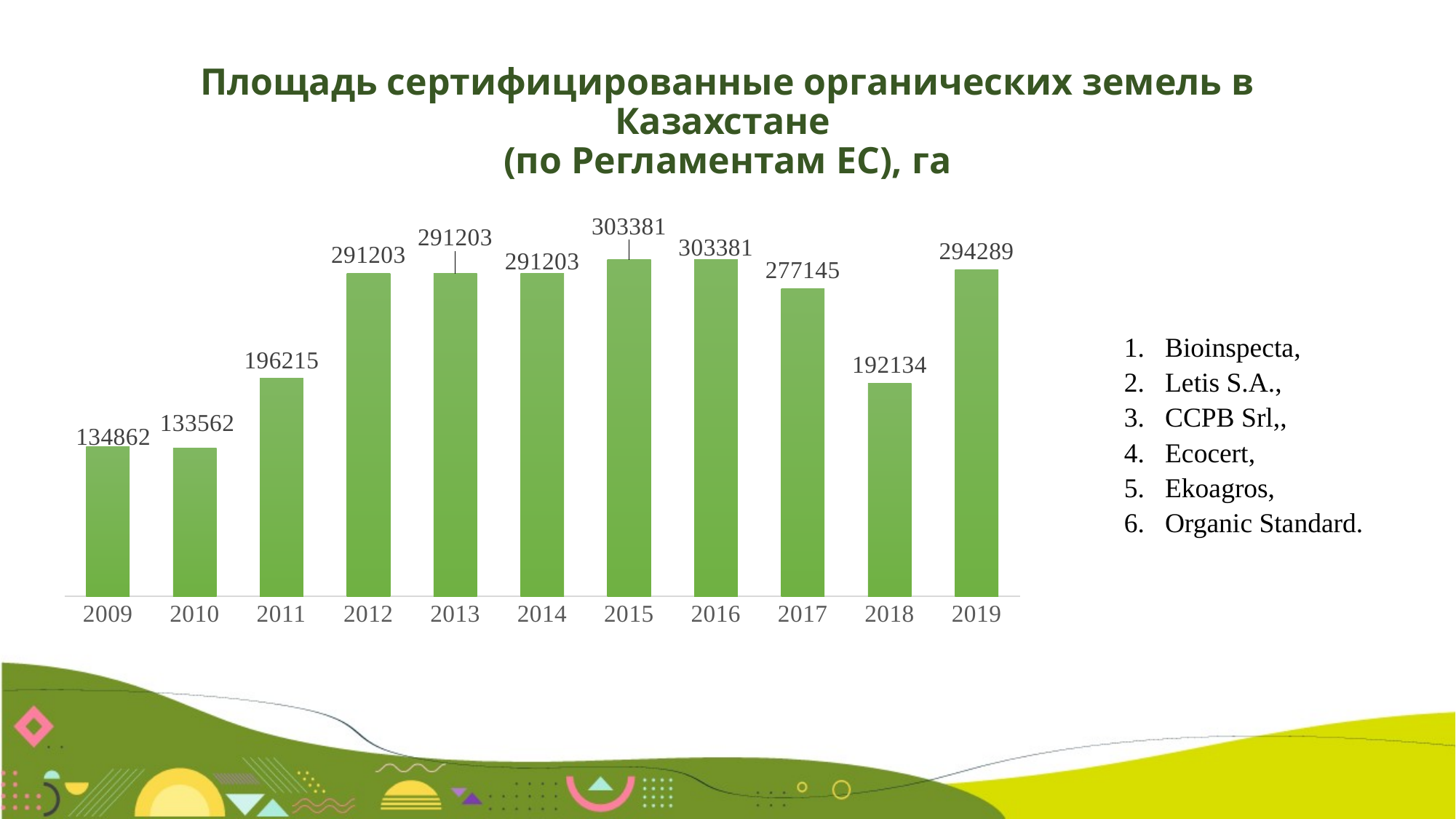
Which year has the larger value, 2011 or 2018? 2011 Do the values rise or fall from 2009 to 2012? Rise What kind of chart is shown on the slide? Bar chart What is the difference between the values for 2016 and 2017? 26236 What is the highest value shown on the chart? 303381 What is the value for 2019? 294289 Which year has the larger value, 2009 or 2010? 2009 Which year has the lowest value? 2010 What is the difference between the values for 2019 and 2018? 102155 What value is shown for 2018? 192134 How many years are shown on the x axis? 11 What is the certified organic land area for 2012? 291203